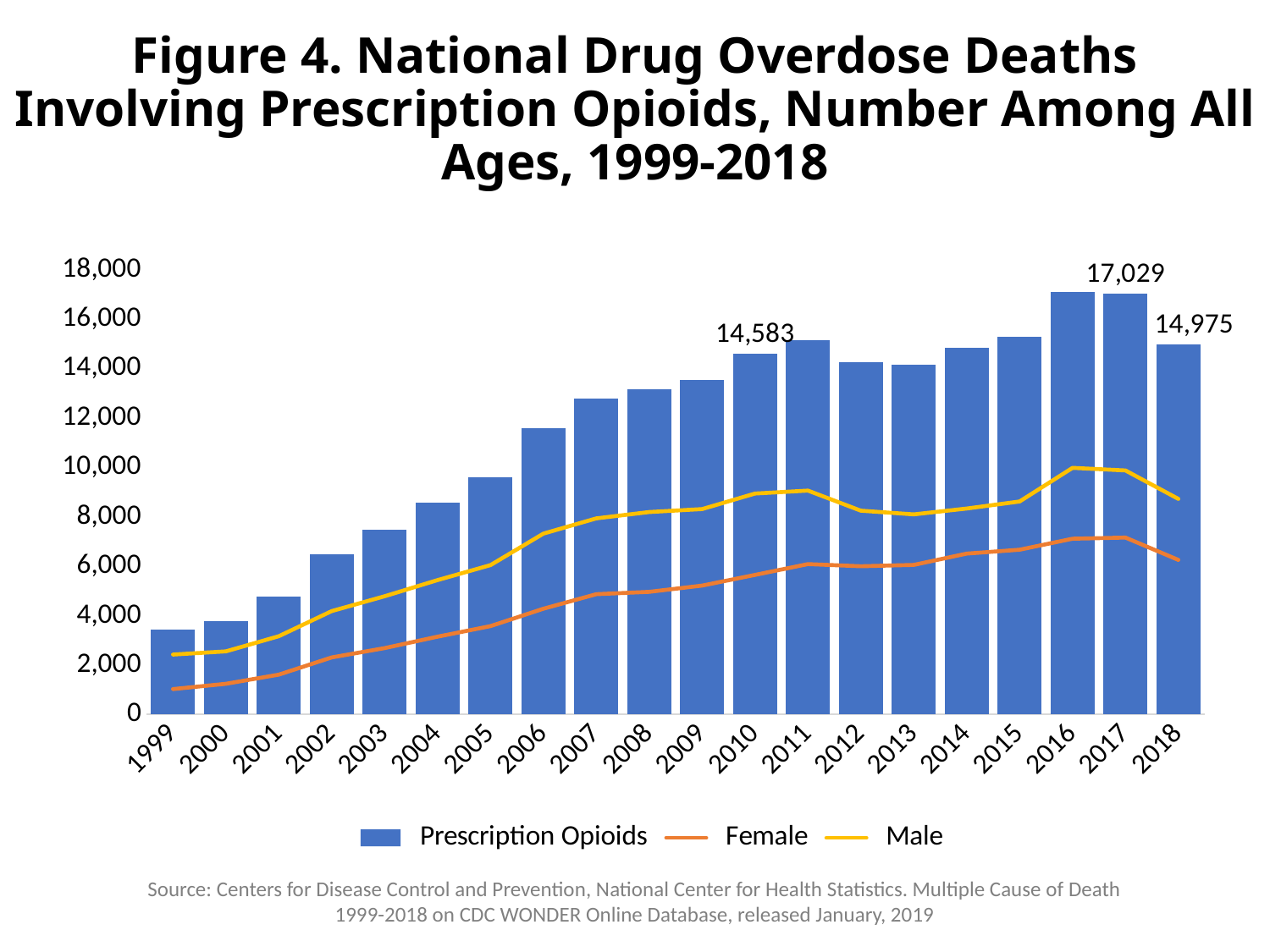
Which year had more prescription opioid deaths, 2010 or 2018? 2018 Is the Prescription Opioids value for 2006 greater or less than 10,000? greater How many series does the legend list? 3 Which year has the lowest number of prescription opioid overdose deaths? 1999 How many years are shown on the x axis? 20 What is the number of prescription opioid overdose deaths shown for 2017? 17,029 Which line is higher in 2018, Male or Female? Male What is the number of prescription opioid overdose deaths shown for 2010? 14,583 What is the difference between the 2017 and 2010 prescription opioid death counts? 2,446 Is the Prescription Opioids value for 2005 greater or less than 10,000? less By how much did the number of prescription opioid deaths fall from 2017 to 2018? 2,054 What is the number of prescription opioid overdose deaths shown for 2018? 14,975